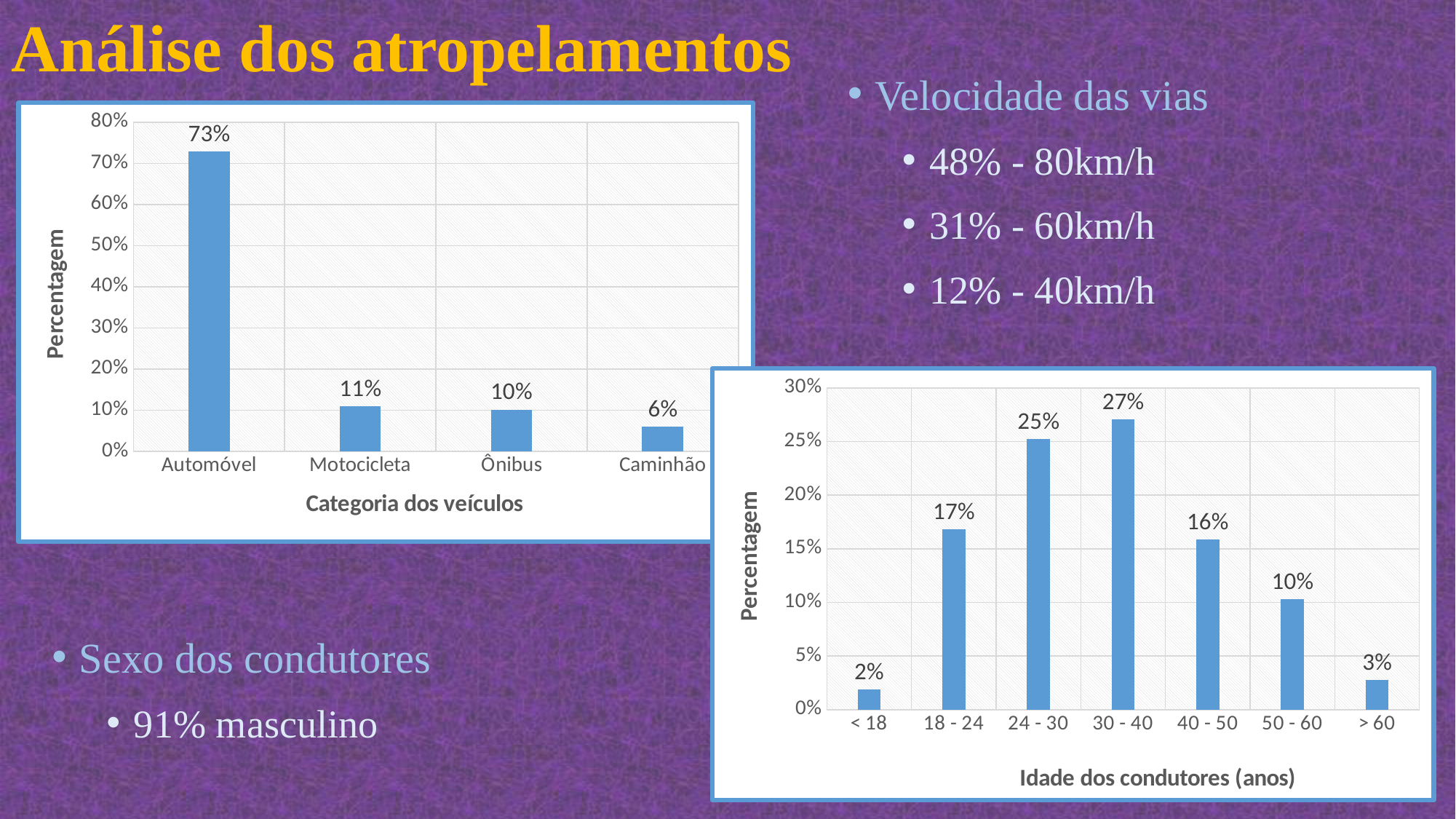
What kind of chart is the bottom-right chart (Idade dos condutores)? Bar chart In the bottom-right chart (Idade dos condutores), which is larger, the value for 18 - 24 or the value for 40 - 50? 18 - 24 In the bottom-right chart (Idade dos condutores), how many age groups are shown on the x axis? 7 In the top-left chart (Categoria dos veículos), what is the label of the y axis? Percentagem In the bottom-right chart (Idade dos condutores), what is the value for the 50 - 60 age group? 10% In the top-left chart (Categoria dos veículos), what is the difference between Automóvel and Motocicleta? 62% In the top-left chart (Categoria dos veículos), what is the value for Caminhão? 6% In the bottom-right chart (Idade dos condutores), which age group has the highest value? 30 - 40 In the top-left chart (Categoria dos veículos), what is the value for Automóvel? 73% In the top-left chart (Categoria dos veículos), how many categories are shown on the x axis? 4 In the bottom-right chart (Idade dos condutores), what is the value for the 30 - 40 age group? 27% In the top-left chart (Categoria dos veículos), which category has the lowest value? Caminhão